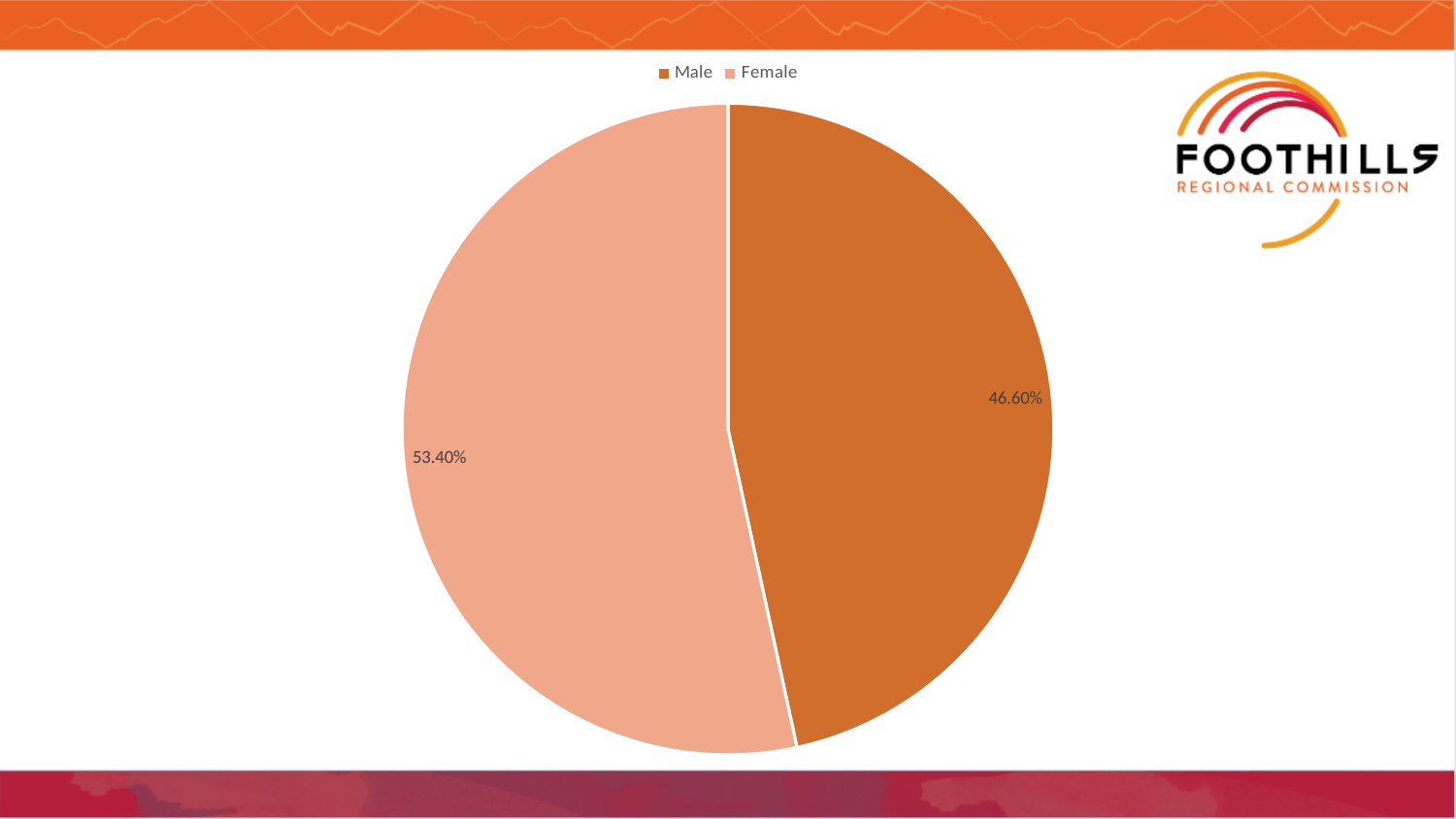
Which is larger, the Male slice or the Female slice? Female What percentage of the pie is Male? 46.60% Which slice is the smallest? Male How many slices does the pie chart have? 2 Which legend entry is shown in the darker orange colour? Male What is the difference between the Female and Male shares? 6.80% What percentage of the pie is Female? 53.40% How many entries does the legend list? 2 What kind of chart is shown on the slide? pie chart Where is the legend positioned relative to the pie? above the pie What share of the pie does the Female slice represent? 53.40% Which slice is the largest? Female